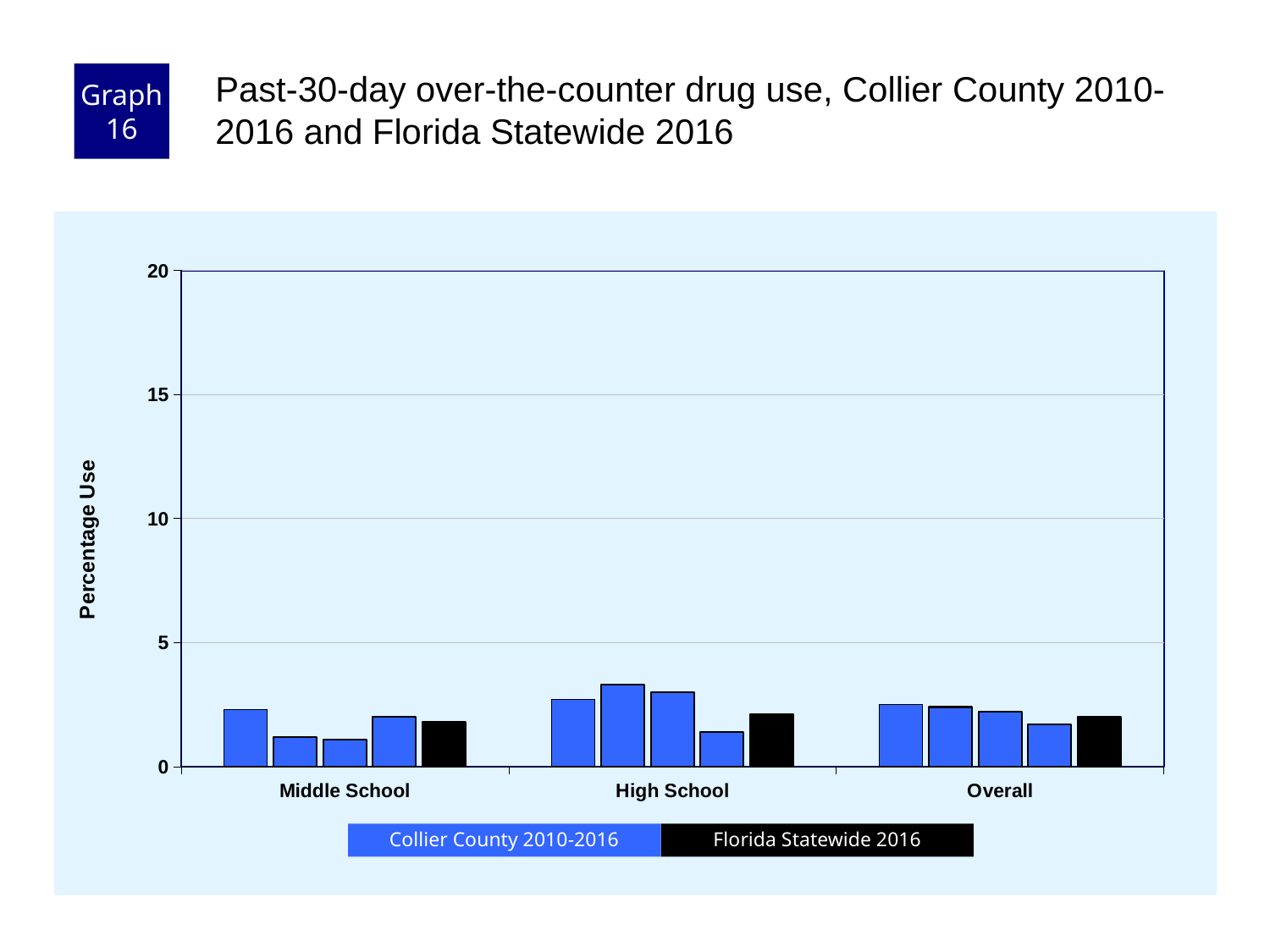
How many categories are shown along the x axis? 3 Is the Florida Statewide 2016 value for Overall greater or less than 10? less Which is larger, the Florida Statewide 2016 value for High School or for Middle School? High School Which category contains the shortest bar on the chart? Middle School Is the Florida Statewide 2016 value for Middle School greater or less than 5? less What is the title of the chart? Past-30-day over-the-counter drug use, Collier County 2010-2016 and Florida Statewide 2016 Is the tallest bar in the High School group greater or less than 5? less What kind of chart is shown on the slide? bar chart What is the label on the y axis? Percentage Use Which category contains the tallest bar on the chart? High School How many series does the legend list? 2